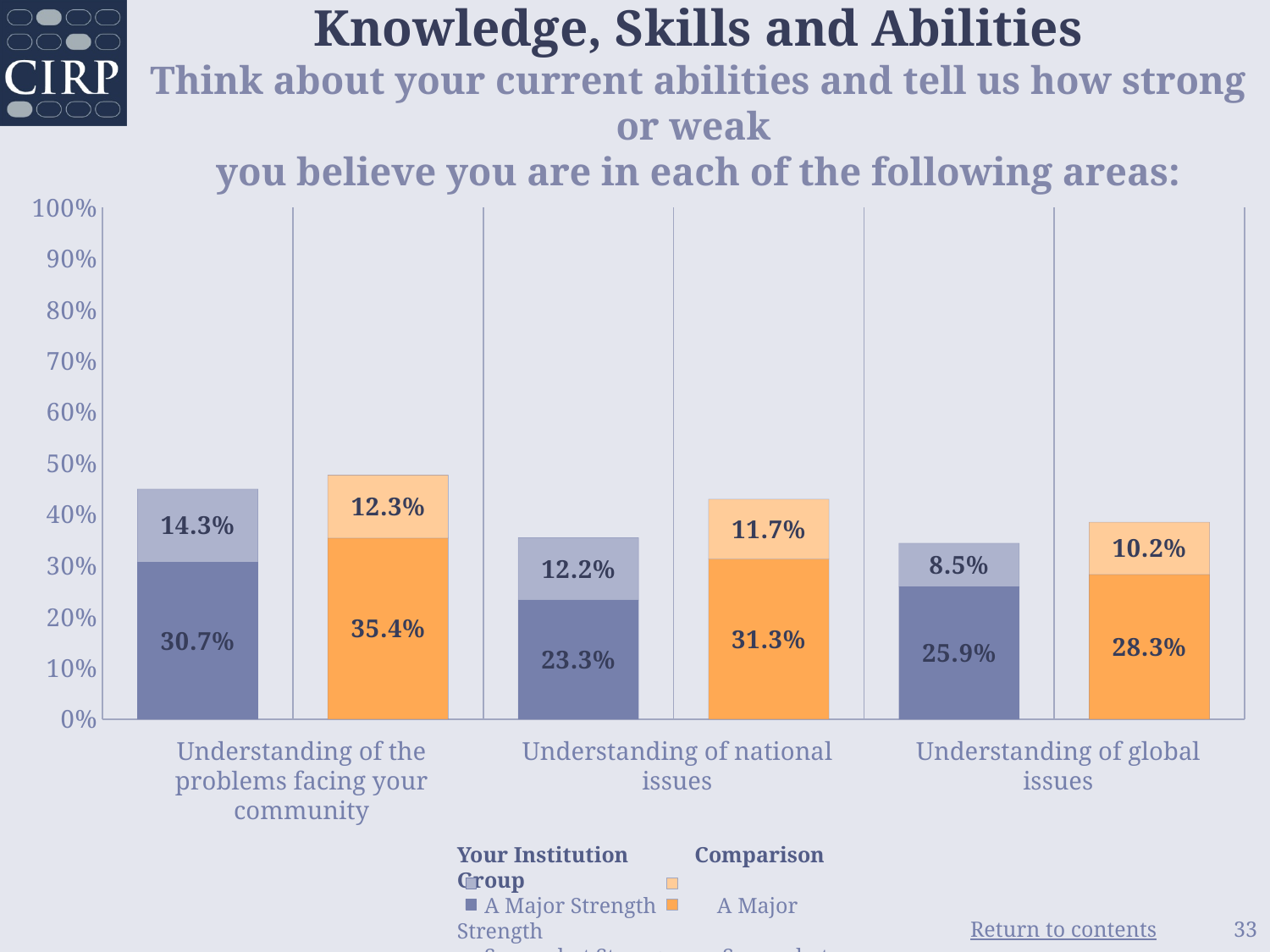
What is the Comparison Group 'A Major Strength' value for 'Understanding of the problems facing your community'? 35.4% What percentage of Your Institution respondents rated 'Understanding of the problems facing your community' as A Major Strength? 30.7% For 'Understanding of the problems facing your community', how much higher is the Comparison Group's 'A Major Strength' value than Your Institution's? 4.7 percentage points What percentage of the Comparison Group rated 'Understanding of national issues' as A Major Strength? 31.3% Which category has the highest Your Institution 'A Major Strength' value? Understanding of the problems facing your community Which bar has the lowest 'A Major Strength' value on the chart? Your Institution, Understanding of national issues (23.3%) What is the total height of the Comparison Group stacked bar for 'Understanding of national issues'? 43.0% What is the total height of the Your Institution stacked bar for 'Understanding of the problems facing your community'? 45.0% What type of chart is shown on the slide? Stacked bar chart For Your Institution, which has the larger 'A Major Strength' value: 'Understanding of national issues' or 'Understanding of global issues'? Understanding of global issues What is the Your Institution 'A Major Strength' value for 'Understanding of global issues'? 25.9% How many categories are shown on the x axis of the chart? 3